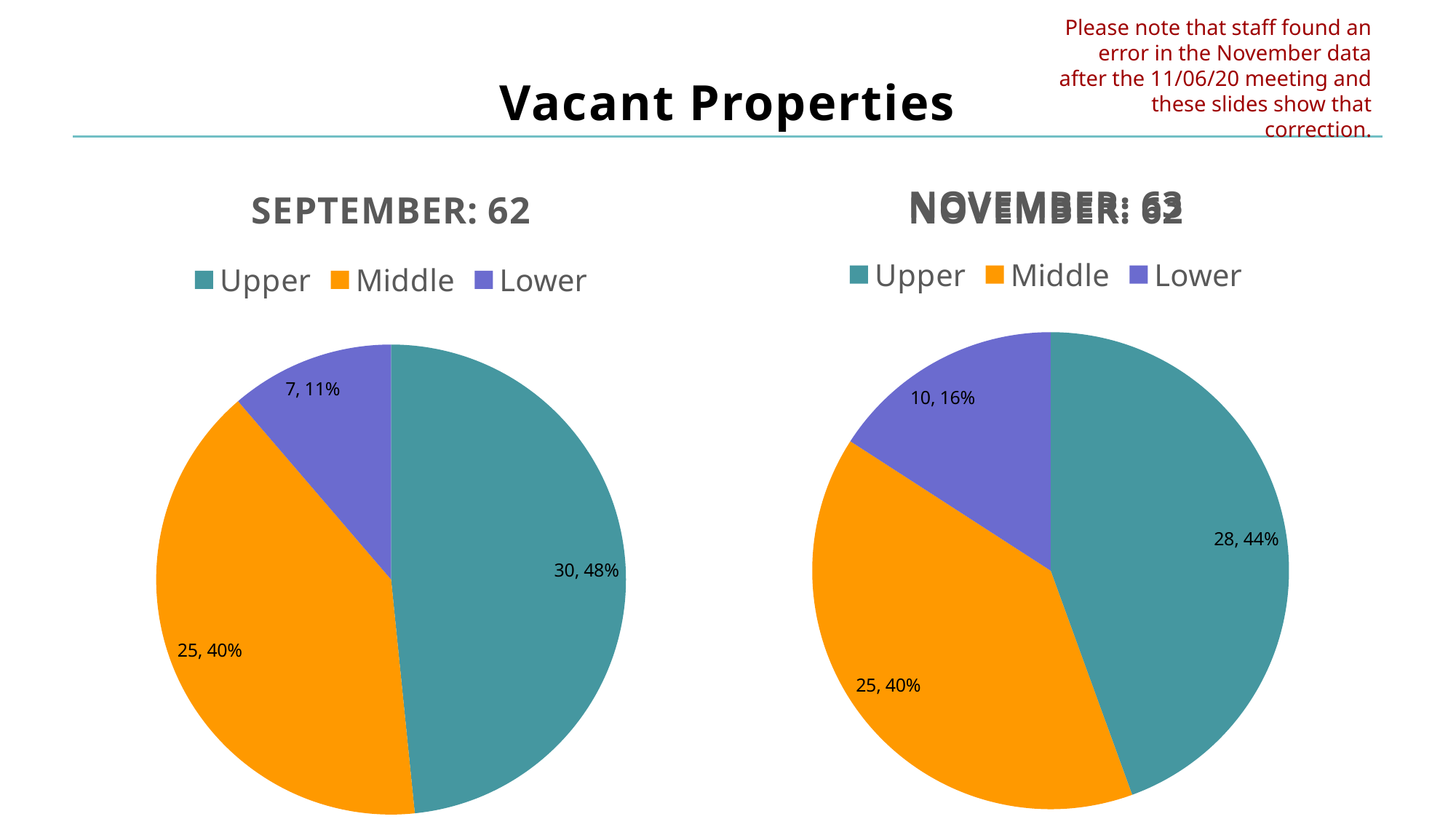
What is the total shown in the title of the September chart? 62 What kind of chart is used for the November data on the right? Pie chart In the September chart, how many more properties are in the Middle category than in the Lower category? 18 How many categories does the September chart show? 3 Which is larger: the Lower count in the September chart or the Lower count in the November chart? November In the November chart (right-hand pie), what share of the pie does the Upper slice represent? 44% What is the difference between the Upper count in the September chart and the Upper count in the November chart? 2 In the November chart (right-hand pie), which category has the smallest slice? Lower In the November chart (right-hand pie), how many vacant properties are in the Lower category? 10 In the September chart, which category has the largest slice? Upper In the September chart, how many vacant properties are in the Upper category? 30 In the September chart, what share of the pie does the Lower slice represent? 11%